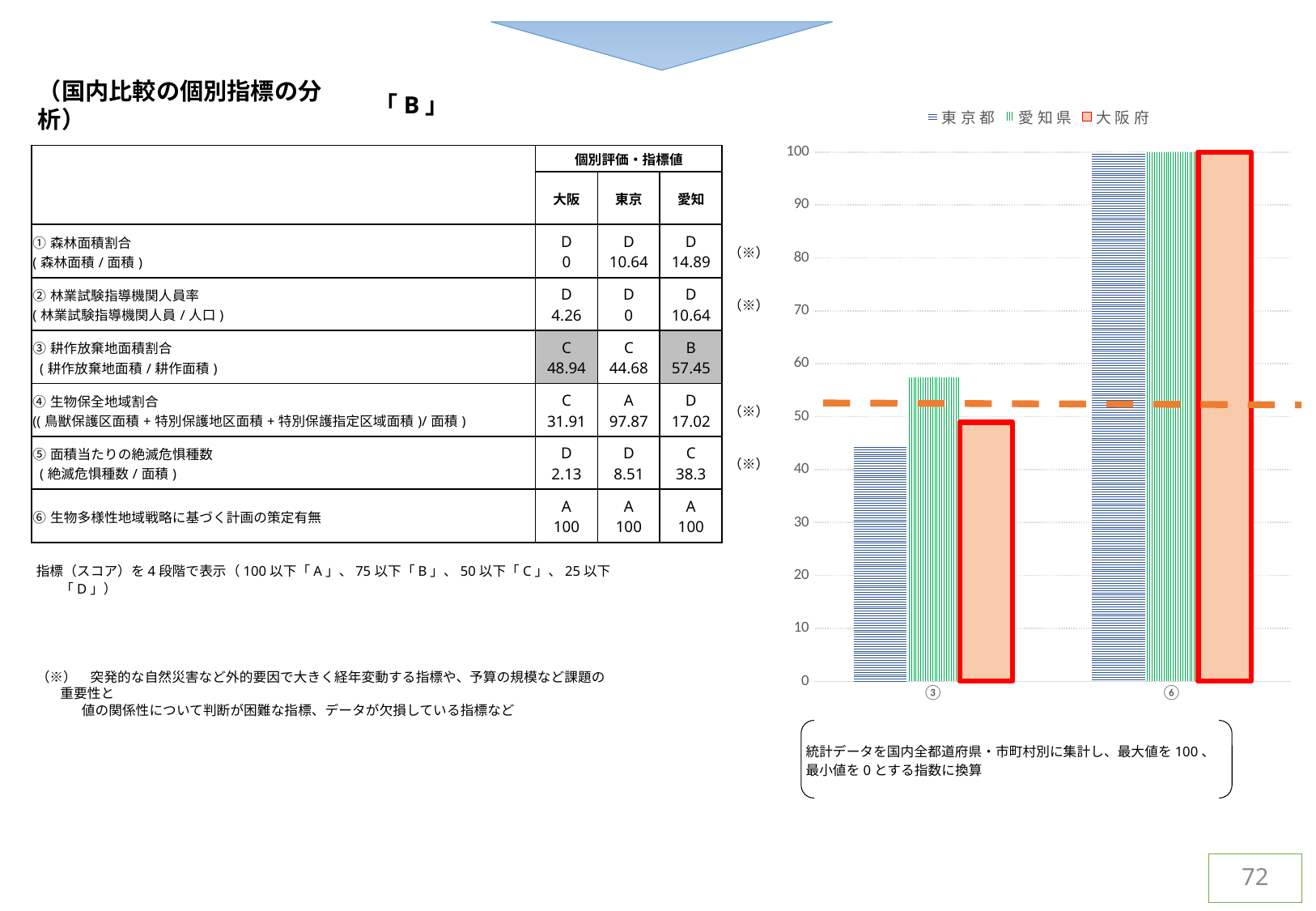
What kind of chart is shown on the right side of the slide? bar chart In the bar chart, is the value for 愛知県 in category ③ greater or less than 50? greater In the bar chart, what is the value for 東京都 in category ⑥? 100 Which series in the bar chart is drawn with a red outline? 大阪府 In the bar chart, is the value for 大阪府 in category ③ greater or less than 60? less How many series does the legend of the bar chart list? 3 In the bar chart, is the value for 東京都 in category ③ greater or less than 50? less In the bar chart, do the values for 大阪府 rise or fall from category ③ to category ⑥? rise In the bar chart, which series has the highest bar in category ③? 愛知県 How many categories are shown on the x axis of the bar chart? 2 In the bar chart, which is larger in category ③: the value for 愛知県 or the value for 東京都? 愛知県 In the bar chart, what is the value for 大阪府 in category ⑥? 100